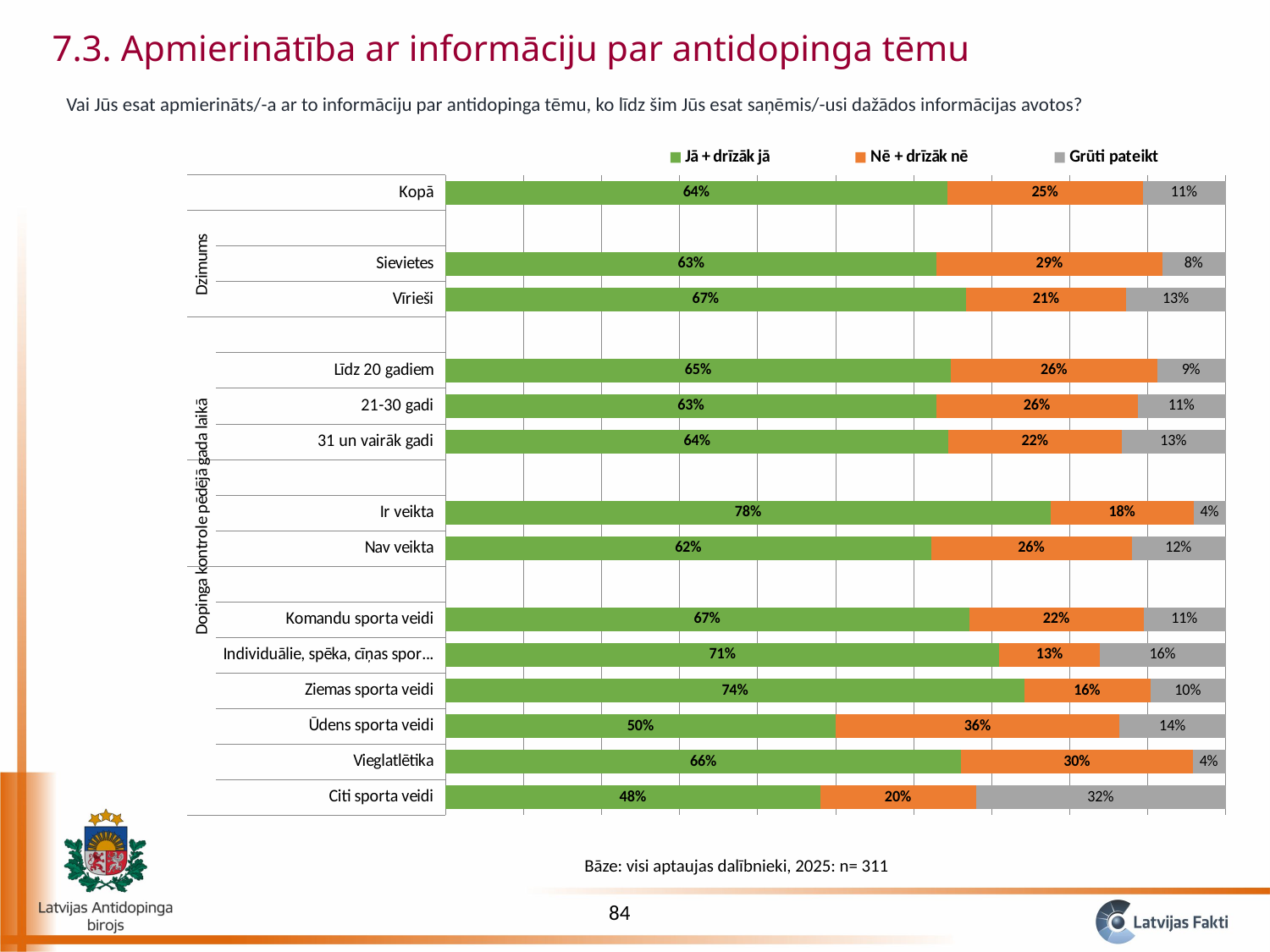
What is the total of the three segments for Ūdens sporta veidi? 100% What is the "Nē + drīzāk nē" value for Sievietes? 29% How many categories are plotted in the chart? 14 What kind of chart is shown on the slide? Stacked bar chart Which is larger: the "Nē + drīzāk nē" value for Vieglatlētika or for Ziemas sporta veidi? Vieglatlētika Which category has the lowest "Jā + drīzāk jā" value? Citi sporta veidi Which category has the highest "Nē + drīzāk nē" value? Ūdens sporta veidi Which category has the highest "Jā + drīzāk jā" value? Ir veikta What is the "Jā + drīzāk jā" value for Kopā? 64% What is the "Grūti pateikt" value for Citi sporta veidi? 32% How many series does the legend list? 3 What is the difference between the "Jā + drīzāk jā" values for Vīrieši and Sievietes? 4 percentage points